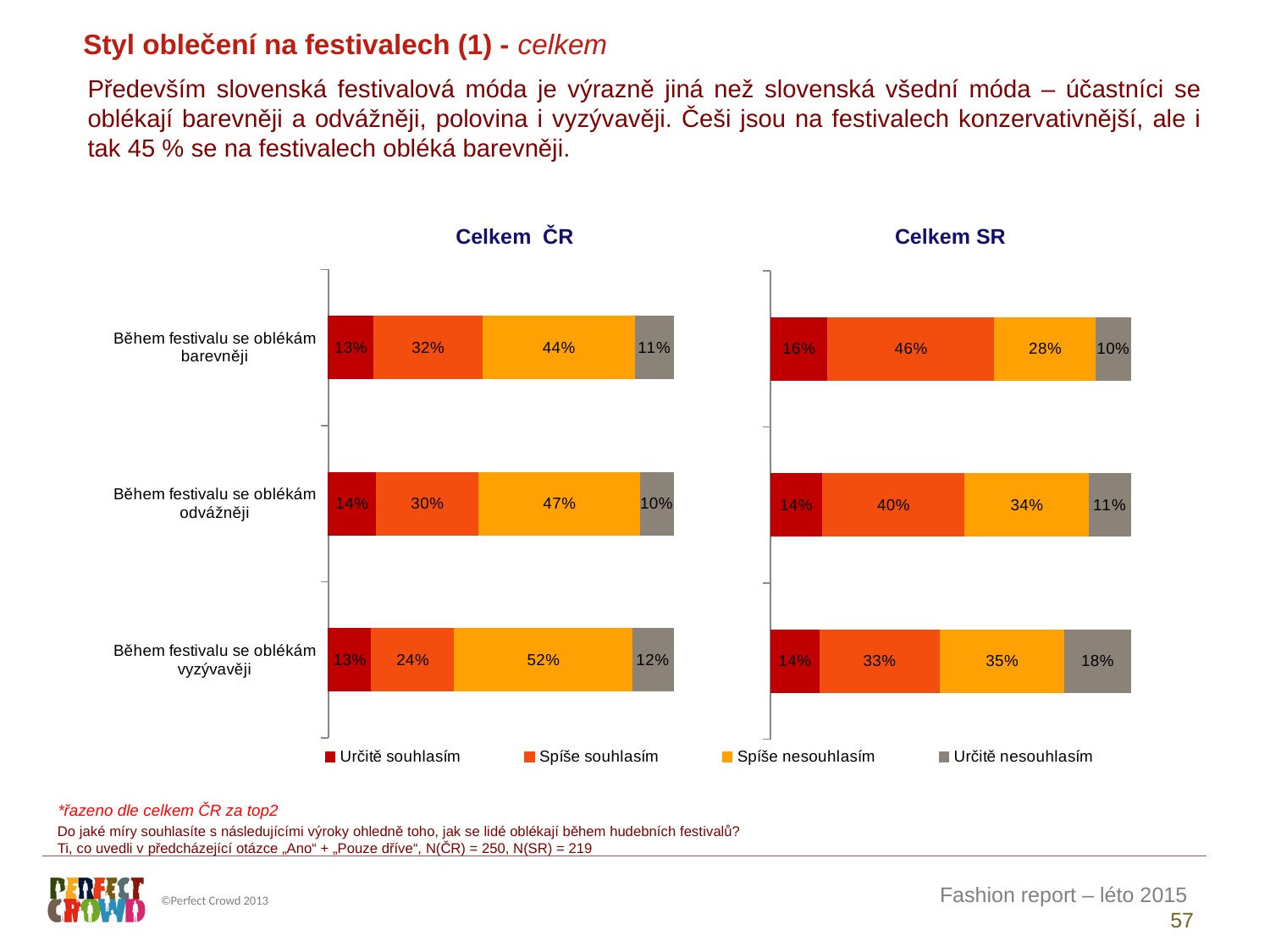
In the Celkem SR chart, which statement has the lowest Spíše souhlasím value? Během festivalu se oblékám vyzývavěji In the Celkem SR chart, which is larger for "Během festivalu se oblékám odvážněji": Spíše souhlasím or Spíše nesouhlasím? Spíše souhlasím In the Celkem ČR chart, which statement has the highest Spíše nesouhlasím value? Během festivalu se oblékám vyzývavěji In the Celkem SR chart, what is the value of Spíše souhlasím for "Během festivalu se oblékám barevněji"? 46% In the Celkem SR chart, what is the value of Určitě nesouhlasím for "Během festivalu se oblékám vyzývavěji"? 18% What type of chart is the Celkem SR chart? Stacked bar chart How many series does the legend list? 4 In the Celkem ČR chart, what is the value of Určitě souhlasím for "Během festivalu se oblékám odvážněji"? 14% What is the difference between the Spíše souhlasím values for "Během festivalu se oblékám barevněji" in the Celkem SR chart and the Celkem ČR chart? 14 percentage points In the Celkem ČR chart, what is the value of Spíše nesouhlasím for "Během festivalu se oblékám vyzývavěji"? 52% How many statements (categories) are shown in the Celkem ČR chart? 3 Which legend entry is shown in grey? Určitě nesouhlasím